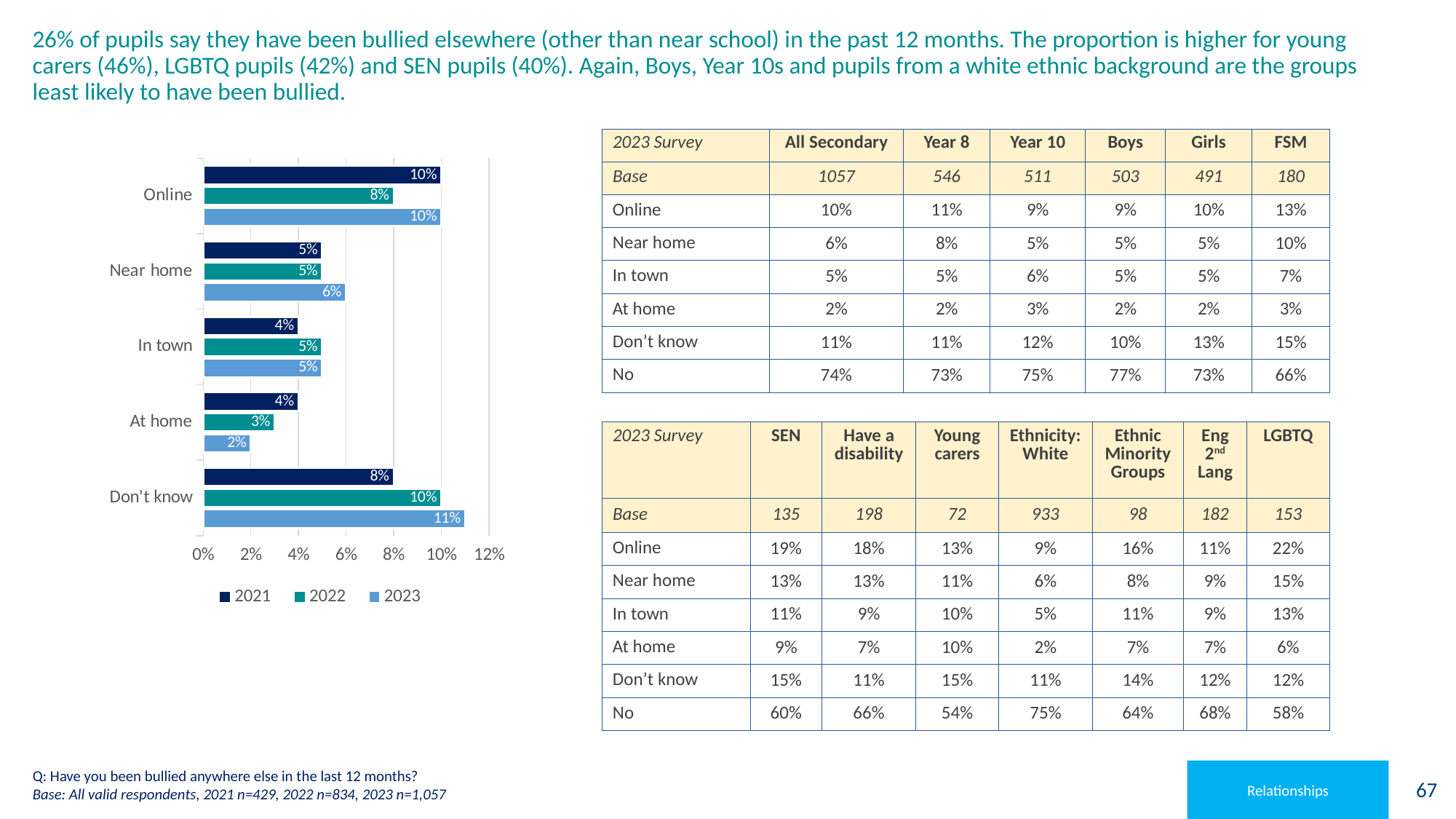
Which category has the lowest 2023 value in the chart? At home Which is larger in the chart: the 2023 value for Don't know or the 2021 value for Don't know? 2023 Which category has the highest 2023 value in the chart? Don't know How many categories are shown on the chart? 5 What is the 2022 value for Don't know in the chart? 10% What type of chart is shown on the slide? bar chart What is the difference between the 2021 and 2022 values for Online in the chart? 2% How many series does the chart legend list? 3 What is the 2021 value for At home in the chart? 4% Which legend entry is shown in the darkest colour in the chart? 2021 Do the values for At home rise or fall from 2021 to 2023 in the chart? fall What is the 2023 value for Online in the chart? 10%